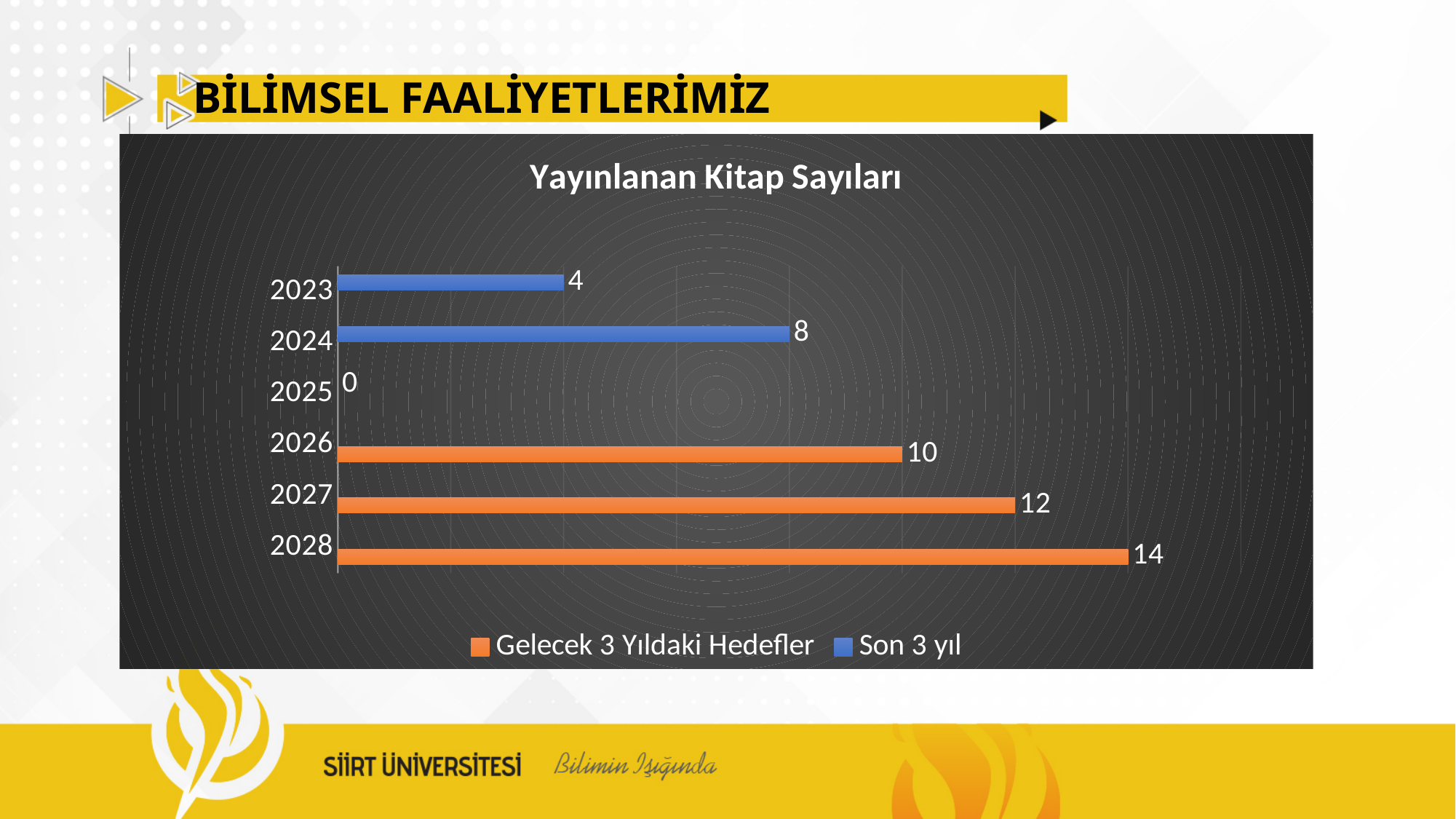
What is the value for 2024 in the 'Son 3 yıl' series? 8 Which year has the highest value in the chart? 2028 What is the value for 2023 in the 'Son 3 yıl' series? 4 What is the value for 2026 in the 'Gelecek 3 Yıldaki Hedefler' series? 10 What is the value shown for 2025? 0 How many series does the legend list? 2 Which is larger, the value for 2024 or the value for 2023? 2024 What is the difference between the values for 2028 and 2027? 2 Which year has the lowest value in the chart? 2025 How many years are shown on the chart? 6 What type of chart is shown on the slide? Bar chart What is the value for 2028 in the 'Gelecek 3 Yıldaki Hedefler' series? 14